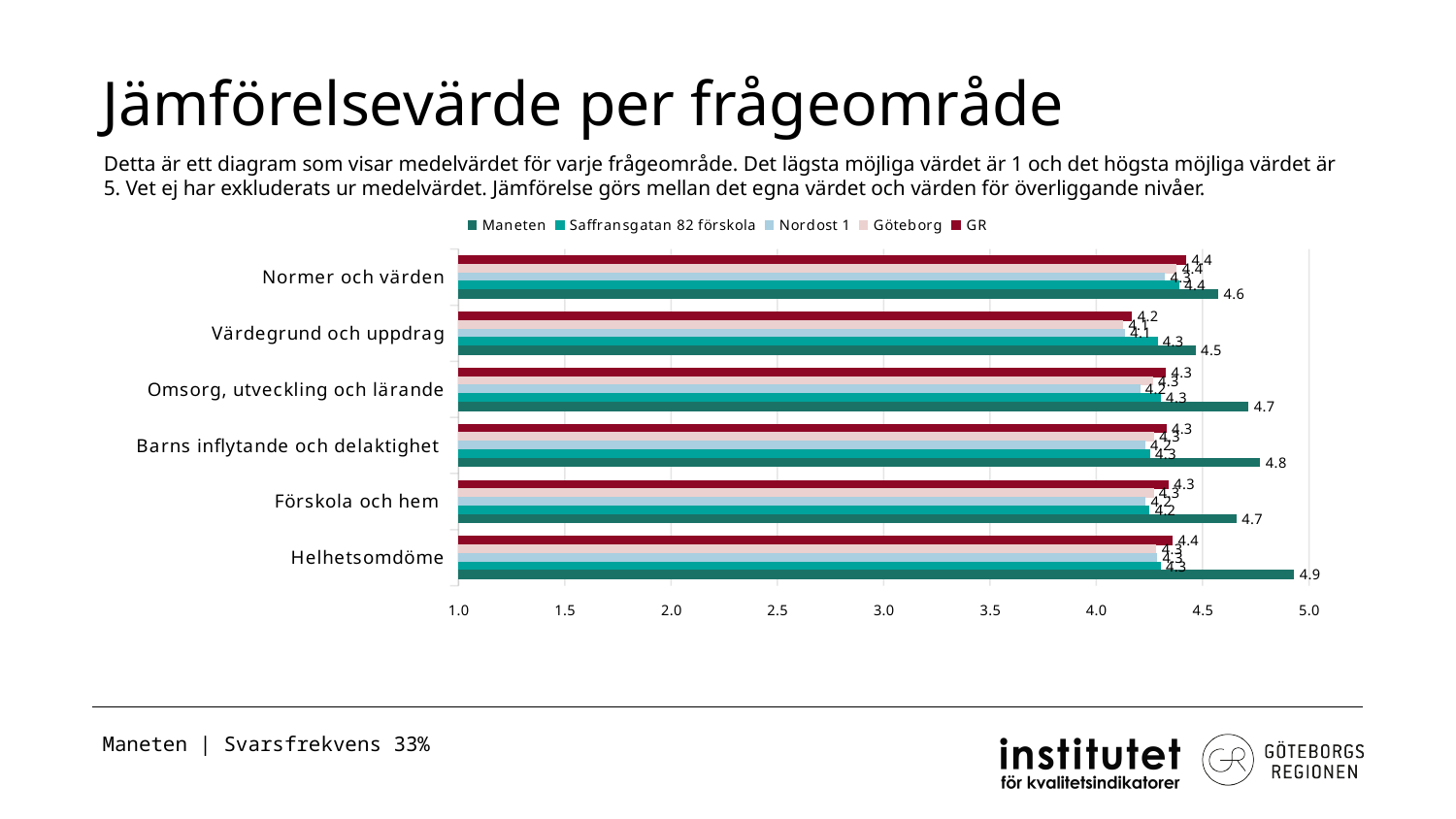
What is the difference between the Maneten value and the Saffransgatan 82 förskola value in Helhetsomdöme? 0.6 Which category has the lowest value for Maneten? Värdegrund och uppdrag Is the value for Maneten in Värdegrund och uppdrag greater or less than 4.0? greater How many series does the legend list? 5 What is the value for Maneten in Normer och värden? 4.6 What is the value for Maneten in Helhetsomdöme? 4.9 What is the value for Maneten in Barns inflytande och delaktighet? 4.8 Which is larger in Omsorg, utveckling och lärande: the value for Maneten or the value for GR? Maneten What kind of chart is shown on the slide? bar chart What is the title of the chart on the slide? Jämförelsevärde per frågeområde Which category has the highest value for Maneten? Helhetsomdöme How many question areas (categories) are shown on the y axis? 6